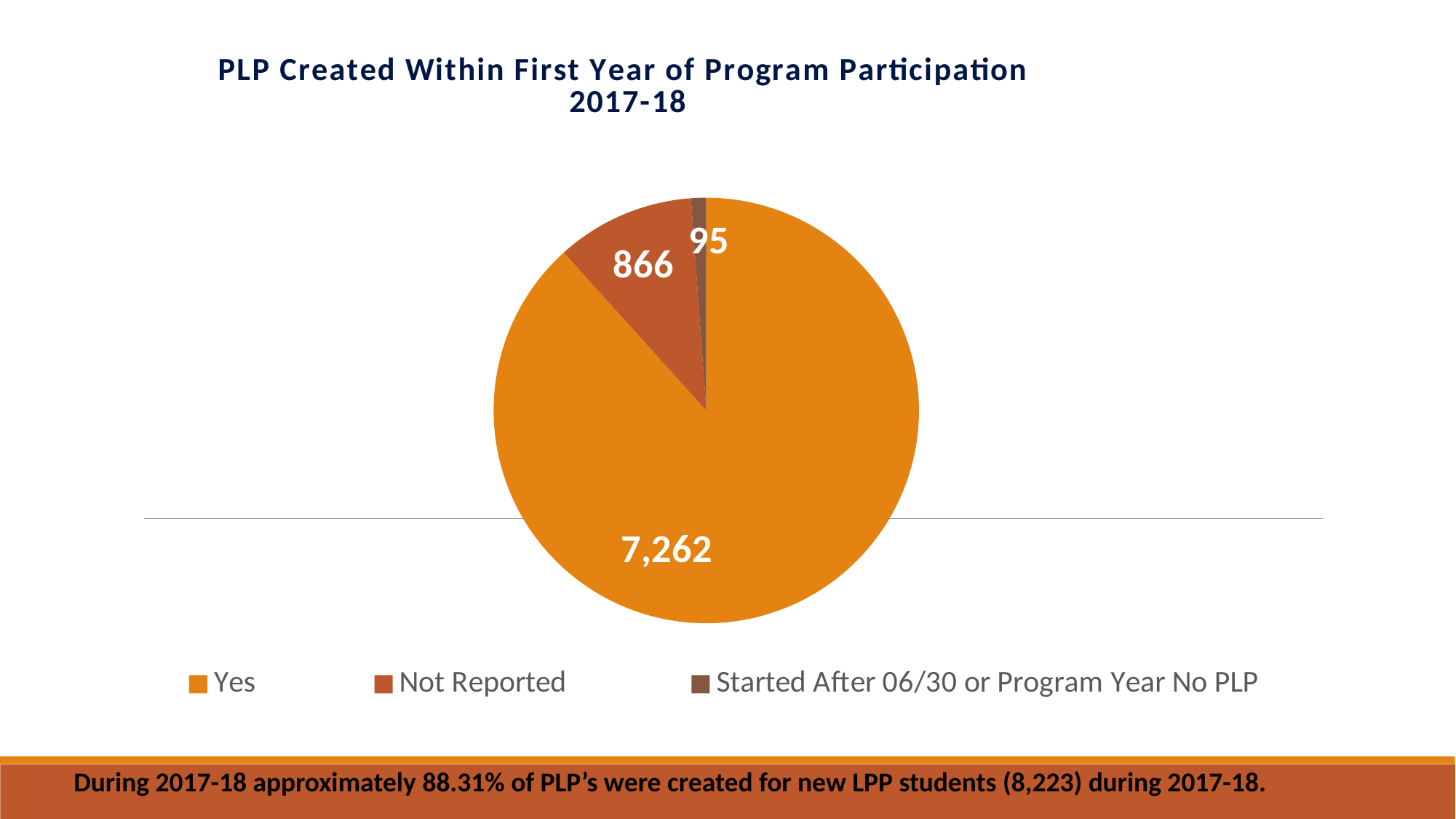
What value is shown for the Yes slice? 7,262 What is the difference between the Not Reported value and the Started After 06/30 or Program Year No PLP value? 771 What is the total of all three slices in the pie chart? 8,223 What kind of chart is shown on the slide? Pie chart Which category has the largest slice of the pie? Yes What value is shown for the Not Reported slice? 866 What is the title of the chart? PLP Created Within First Year of Program Participation 2017-18 What value is shown for the Started After 06/30 or Program Year No PLP slice? 95 Which category has the smallest slice of the pie? Started After 06/30 or Program Year No PLP Which is larger, the Not Reported slice or the Started After 06/30 or Program Year No PLP slice? Not Reported How many slices does the pie chart have? 3 What is the difference between the Yes value and the Not Reported value? 6,396